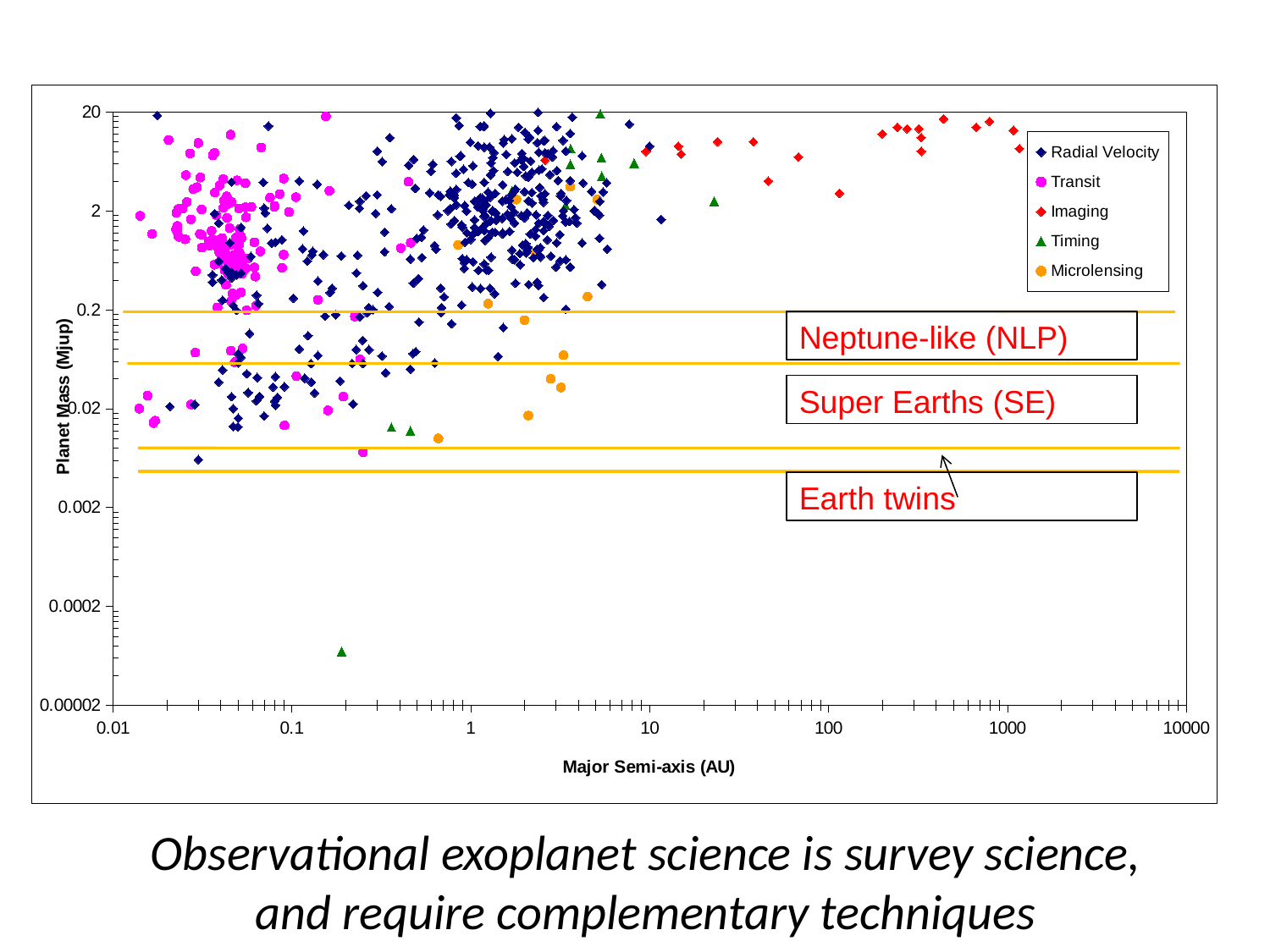
Is the planet mass of the lowest Timing point greater or less than 0.00002 Mjup? greater What is the label of the y axis? Planet Mass (Mjup) What kind of chart is shown on the slide? scatter plot Which series reaches the largest semi-major axis values on the chart? Imaging Are the Transit points plotted at semi-major axes greater or less than 1 AU? less How many series does the legend list? 5 Are the Imaging points plotted at semi-major axes greater or less than 1 AU? greater What is the highest tick value shown on the x axis? 10000 Which series has the point with the lowest planet mass on the chart? Timing What is the label of the x axis? Major Semi-axis (AU)